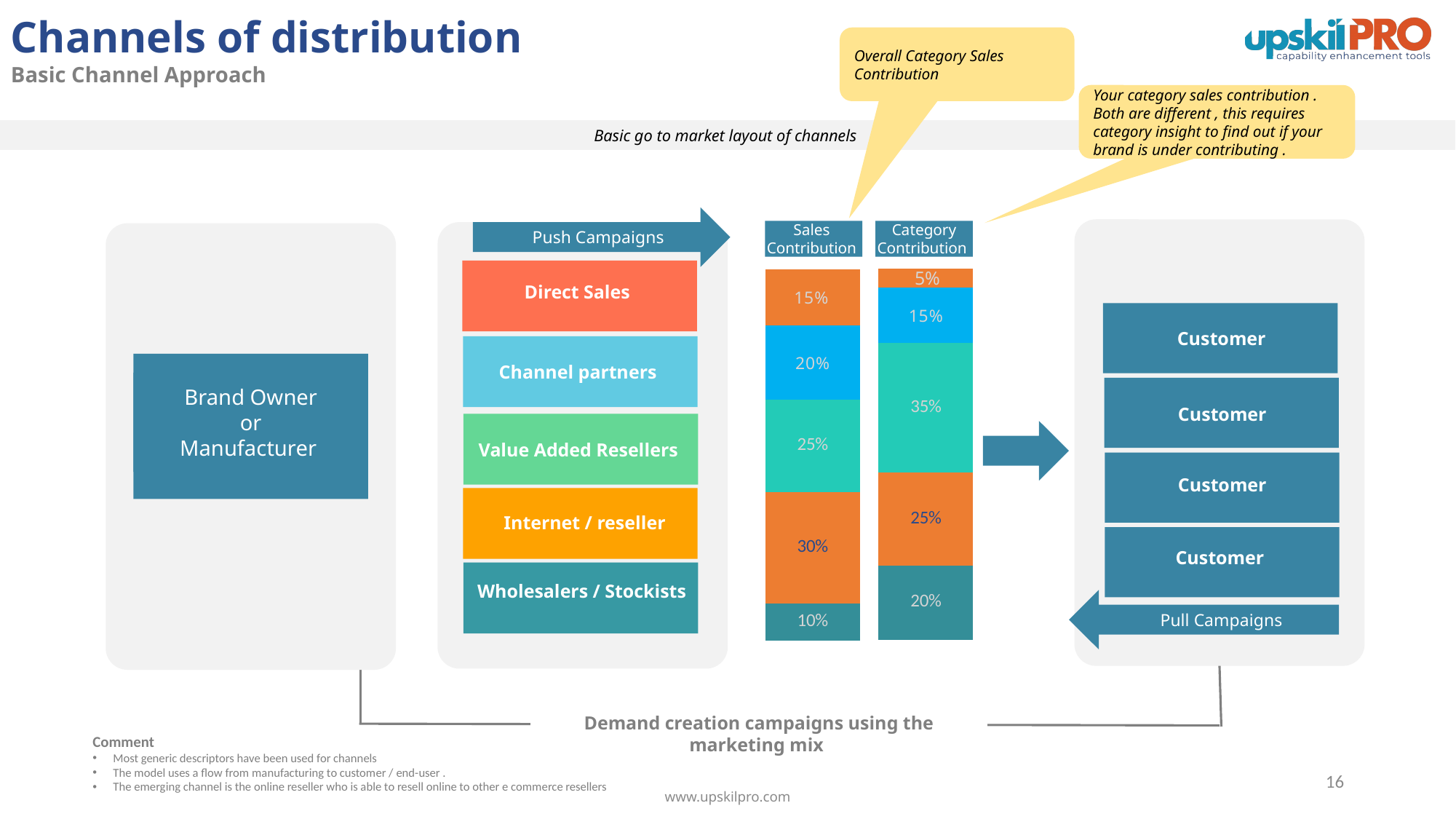
In the Sales Contribution bar, what value is shown for the bottom segment? 10% In the Category Contribution bar, what value is shown for the top segment? 5% In the Category Contribution bar, what is the smallest segment value? 5% What kind of chart is used to show the Sales Contribution and Category Contribution? Stacked bar chart In the Category Contribution bar, what value is shown for the bottom segment? 20% In the Category Contribution bar, what is the largest segment value? 35% What is the total of all segments in the Category Contribution bar? 100% In the Sales Contribution bar, what is the difference between the largest and smallest segment values? 20% How many segments does the Sales Contribution bar contain? 5 In the Sales Contribution bar, what is the largest segment value? 30% Which bar has the larger third segment from the top, Sales Contribution (25%) or Category Contribution (35%)? Category Contribution In the Sales Contribution bar, what value is shown for the top segment? 15%